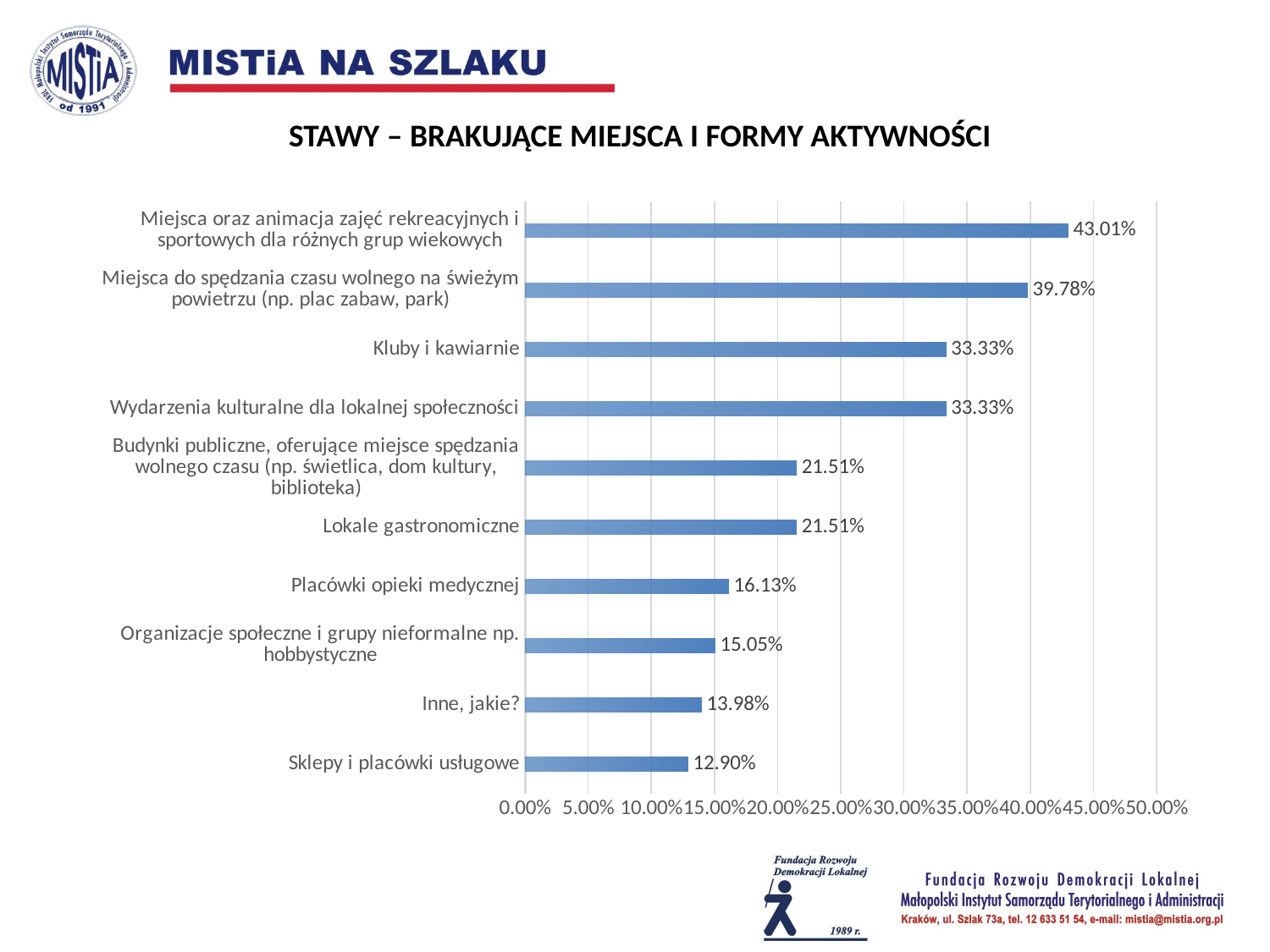
What kind of chart is shown on the slide? bar chart What is the value for "Placówki opieki medycznej"? 16.13% What is the value for "Kluby i kawiarnie"? 33.33% What is the title of the chart? STAWY – BRAKUJĄCE MIEJSCA I FORMY AKTYWNOŚCI What is the value for "Sklepy i placówki usługowe"? 12.90% Is the value for "Organizacje społeczne i grupy nieformalne np. hobbystyczne" greater or less than 20.00%? less How many categories are shown in the chart? 10 What is the difference between the values for "Miejsca oraz animacja zajęć rekreacyjnych i sportowych dla różnych grup wiekowych" and "Miejsca do spędzania czasu wolnego na świeżym powietrzu (np. plac zabaw, park)"? 3.23% Which category has the lowest value? Sklepy i placówki usługowe Which is larger: the value for "Lokale gastronomiczne" or the value for "Placówki opieki medycznej"? Lokale gastronomiczne What is the value for "Inne, jakie?"? 13.98% Which category has the highest value? Miejsca oraz animacja zajęć rekreacyjnych i sportowych dla różnych grup wiekowych